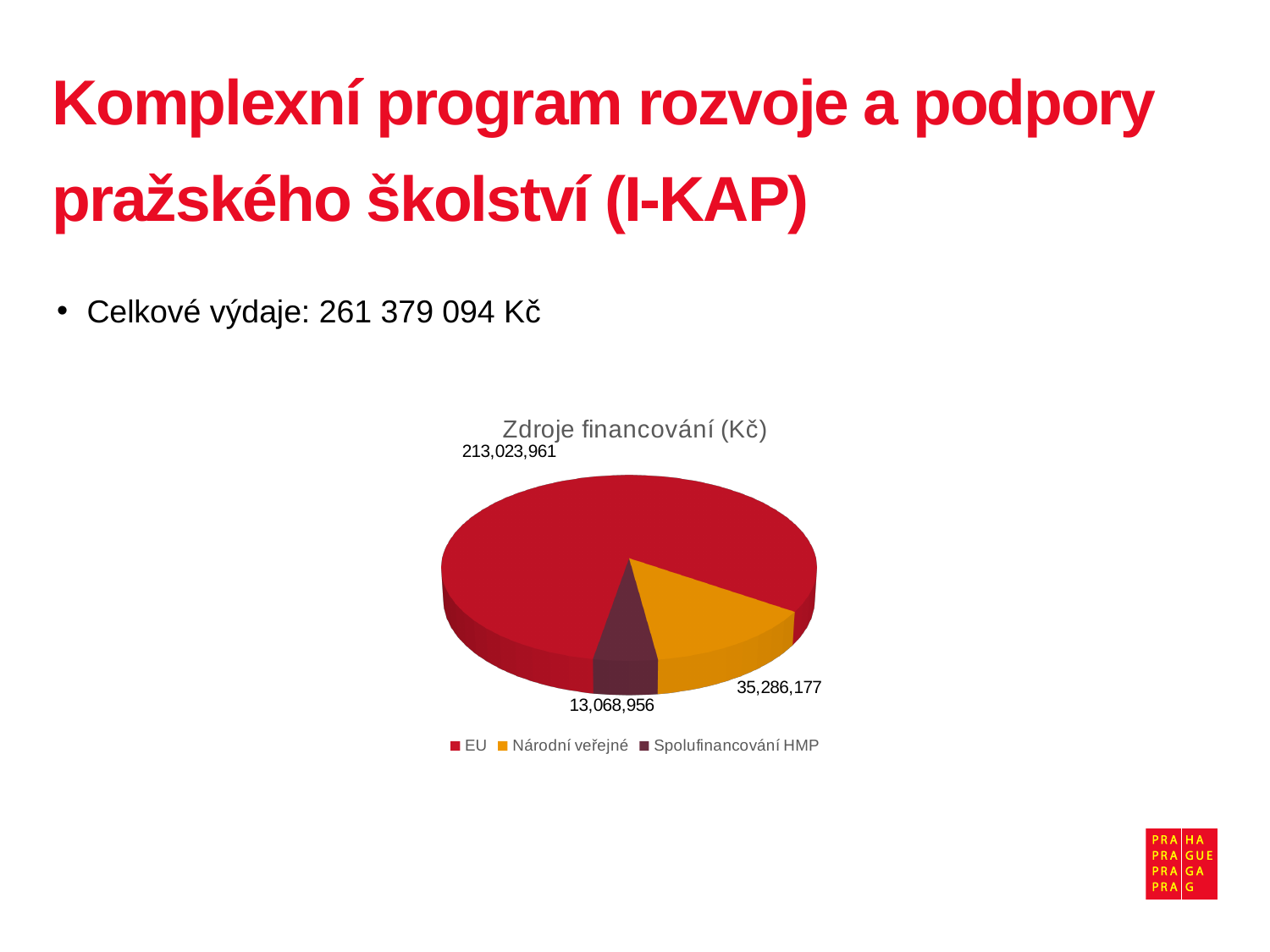
Which source of financing has the largest slice? EU What is the value for EU in the pie chart? 213,023,961 How many entries does the chart legend list? 3 How many slices does the pie chart have? 3 What type of chart is shown on the slide? Pie chart What is the title of the chart? Zdroje financování (Kč) What is the difference between the EU value and the Národní veřejné value? 177,737,784 What is the value for Národní veřejné in the pie chart? 35,286,177 What share of the pie does the EU slice represent? 81.5% Which source of financing has the smallest slice? Spolufinancování HMP What is the value for Spolufinancování HMP in the pie chart? 13,068,956 Which is larger, Národní veřejné or Spolufinancování HMP? Národní veřejné